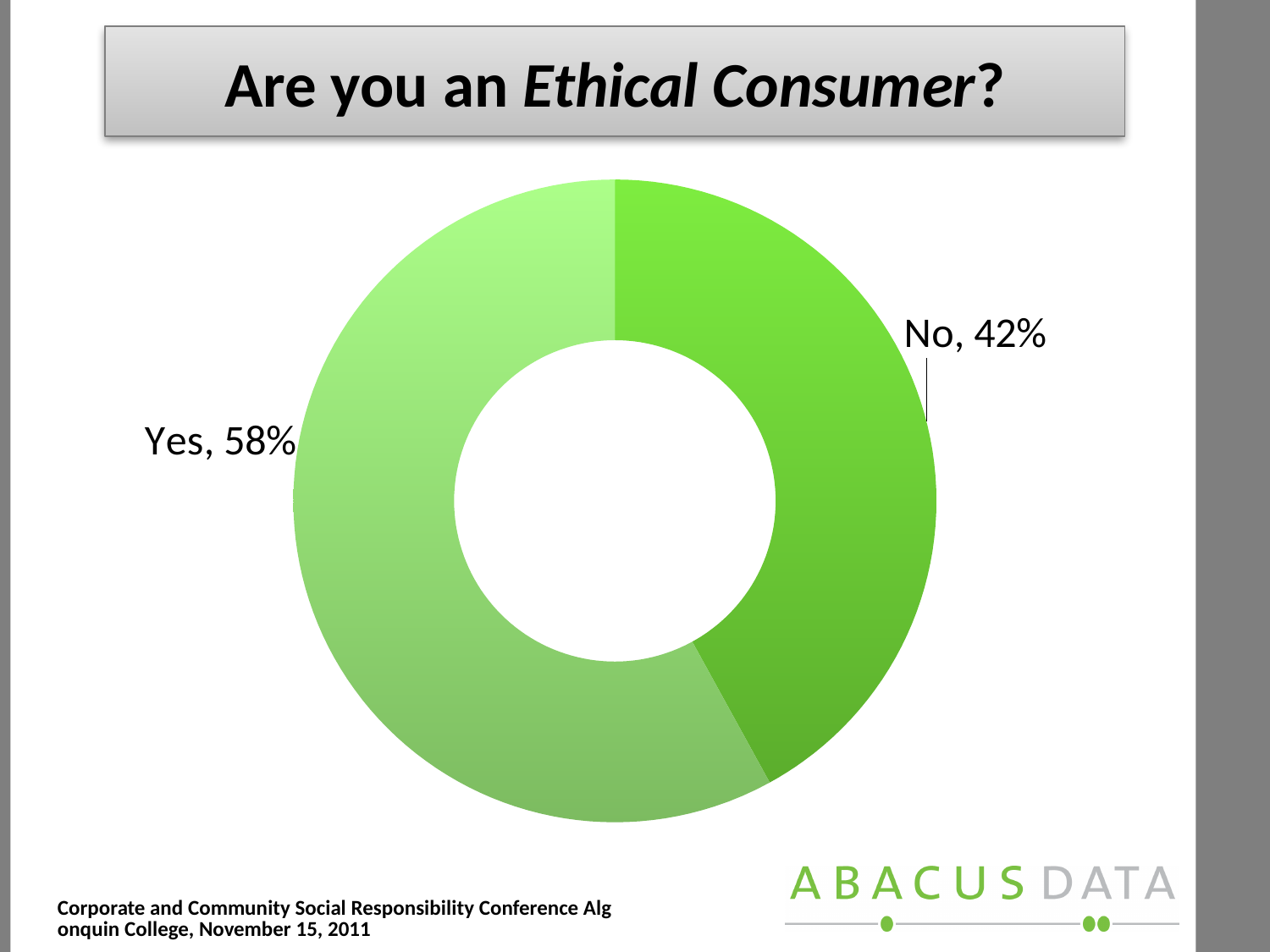
What kind of chart is shown on the slide? Doughnut (pie) chart What share of the chart does the No slice represent? 42% What percentage of respondents answered No? 42% Which response has the smaller share? No What is the title of the slide containing the chart? Are you an Ethical Consumer? What is the total of the Yes and No shares? 100% Which response has the larger share, Yes or No? Yes Which slice is shown in the lighter shade of green? Yes What is the difference in percentage points between the Yes and No shares? 16 What percentage of respondents answered Yes? 58% How many slices does the chart have? 2 Is the share for Yes larger than the share for No? Yes